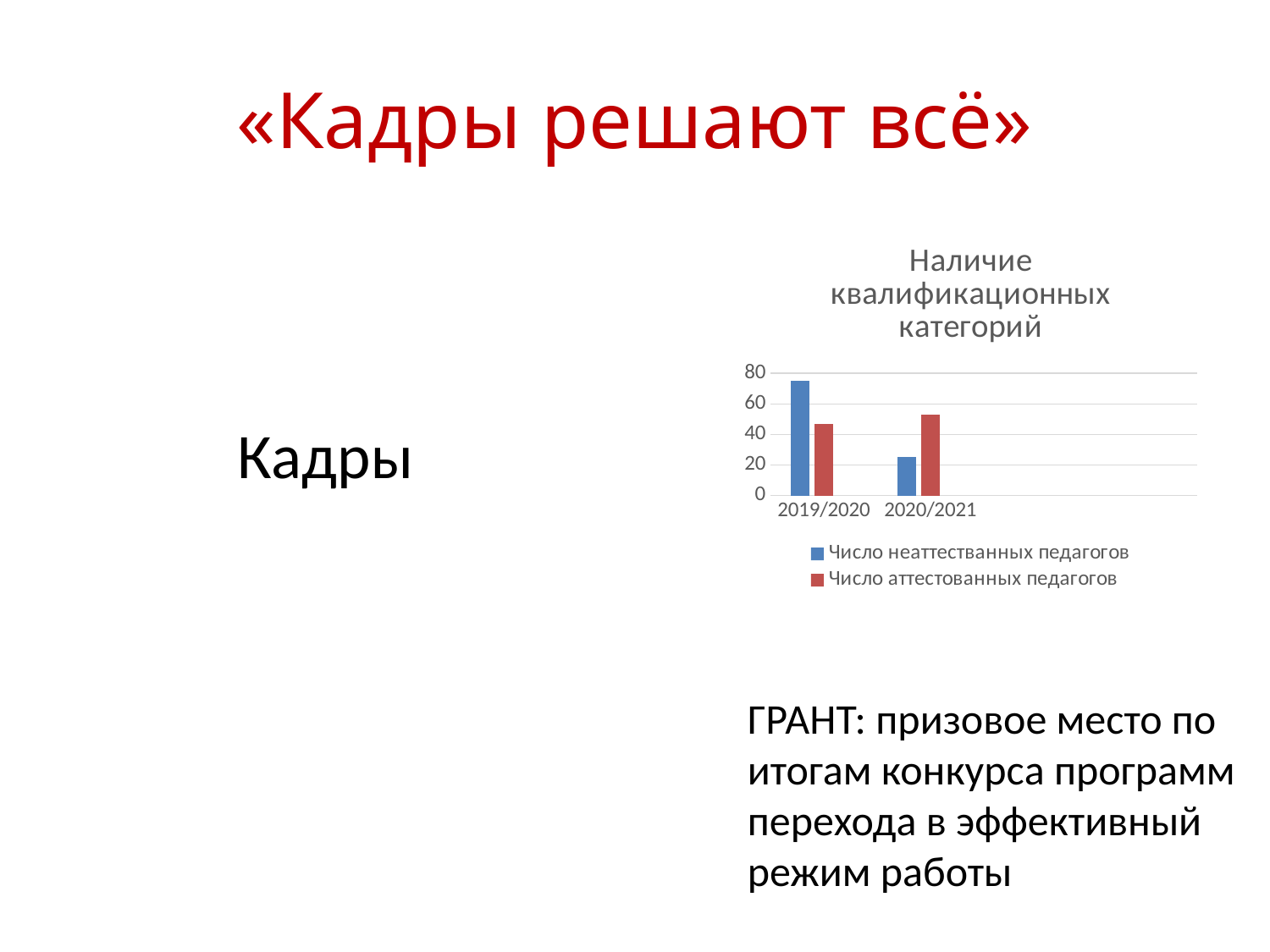
How many categories are shown on the x axis of the chart? 2 In 2019/2020, which is larger: Число неаттестванных педагогов or Число аттестованных педагогов? Число неаттестванных педагогов How many series does the chart legend list? 2 What is the title of the chart? Наличие квалификационных категорий Is the value for Число неаттестванных педагогов in 2020/2021 greater or less than 40? less In 2020/2021, which is larger: Число неаттестванных педагогов or Число аттестованных педагогов? Число аттестованных педагогов Is the value for Число аттестованных педагогов in 2019/2020 greater or less than 60? less Is the value for Число аттестованных педагогов in 2020/2021 greater or less than 40? greater Which series is shown in blue in the chart? Число неаттестванных педагогов What kind of chart is shown on the slide? bar chart Does the value for Число неаттестванных педагогов rise or fall from 2019/2020 to 2020/2021? fall